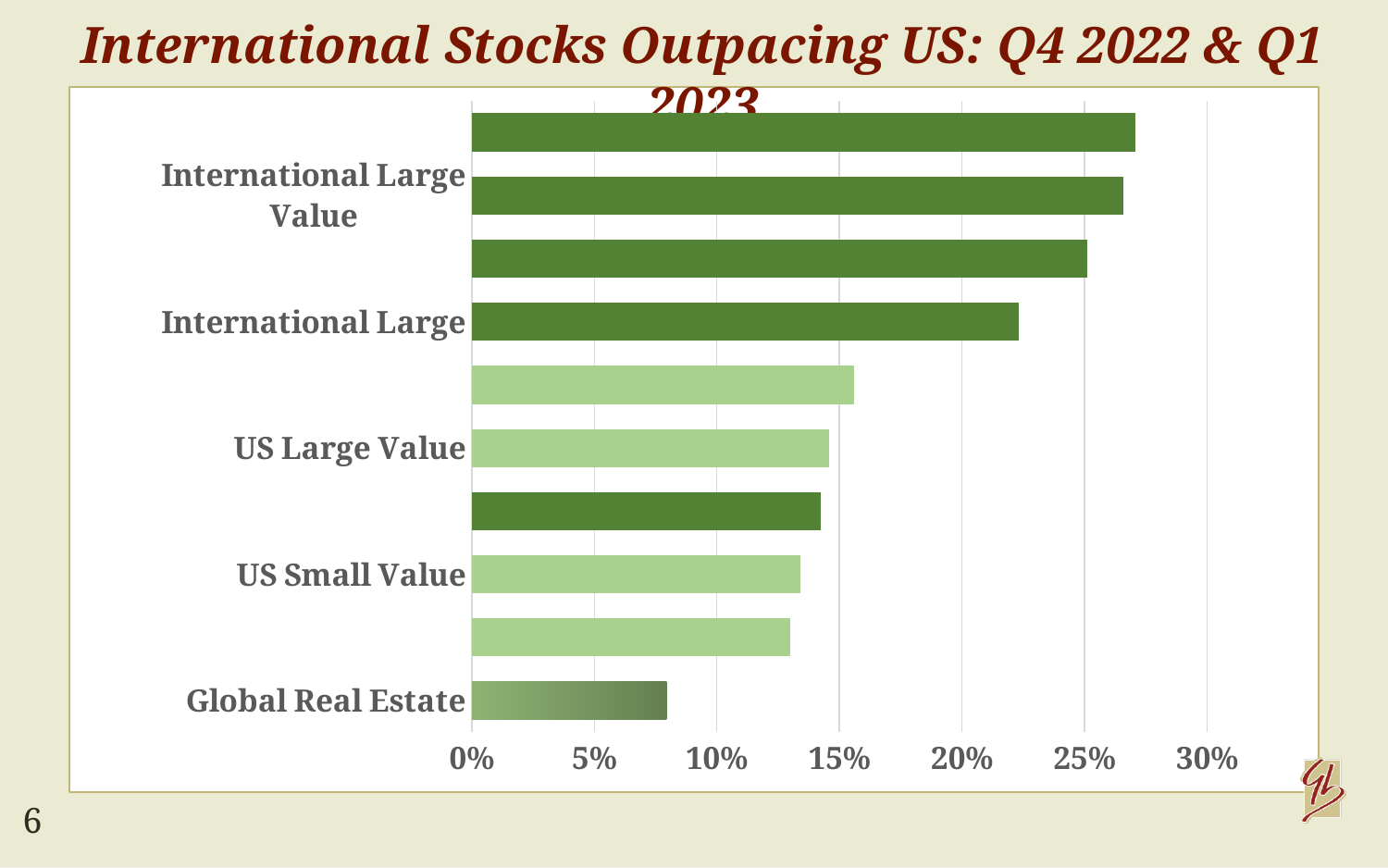
Which labeled category has the lowest value? Global Real Estate Which labeled category has the highest value? International Large Value Which is larger, the value for International Large or the value for US Large Value? International Large Is the value for Global Real Estate greater or less than 10%? less How many bars are plotted in the chart? 10 Is the value for US Large Value greater or less than 20%? less What kind of chart is shown on the slide? bar chart Is the value for US Small Value greater or less than 10%? greater What is the highest tick value shown on the horizontal axis? 30% What is the title of the chart on the slide? International Stocks Outpacing US: Q4 2022 & Q1 2023